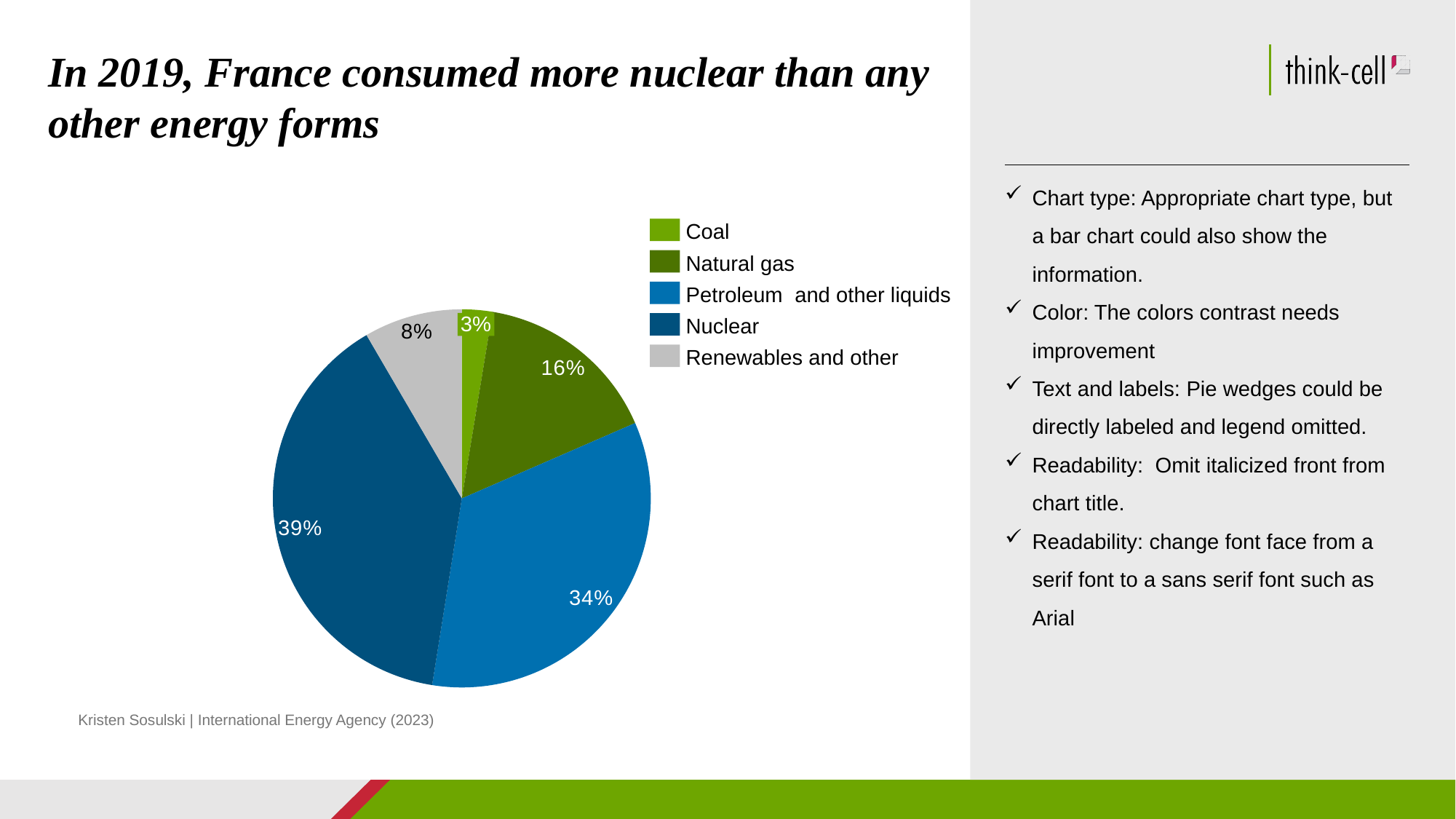
Which is larger, the share for Natural gas or the share for Renewables and other? Natural gas Which category has the smallest slice of the pie? Coal What is the value shown for Coal? 3% What share of the pie does Nuclear represent? 39% What is the value shown for Petroleum and other liquids? 34% What colour is used for the Coal slice in the legend? Light green What is the difference between the Nuclear and Petroleum and other liquids shares? 5% Which category has the largest slice of the pie? Nuclear What kind of chart is shown on the slide? Pie chart What is the value shown for Renewables and other? 8% What is the value shown for Natural gas? 16% How many categories are shown in the pie chart? 5